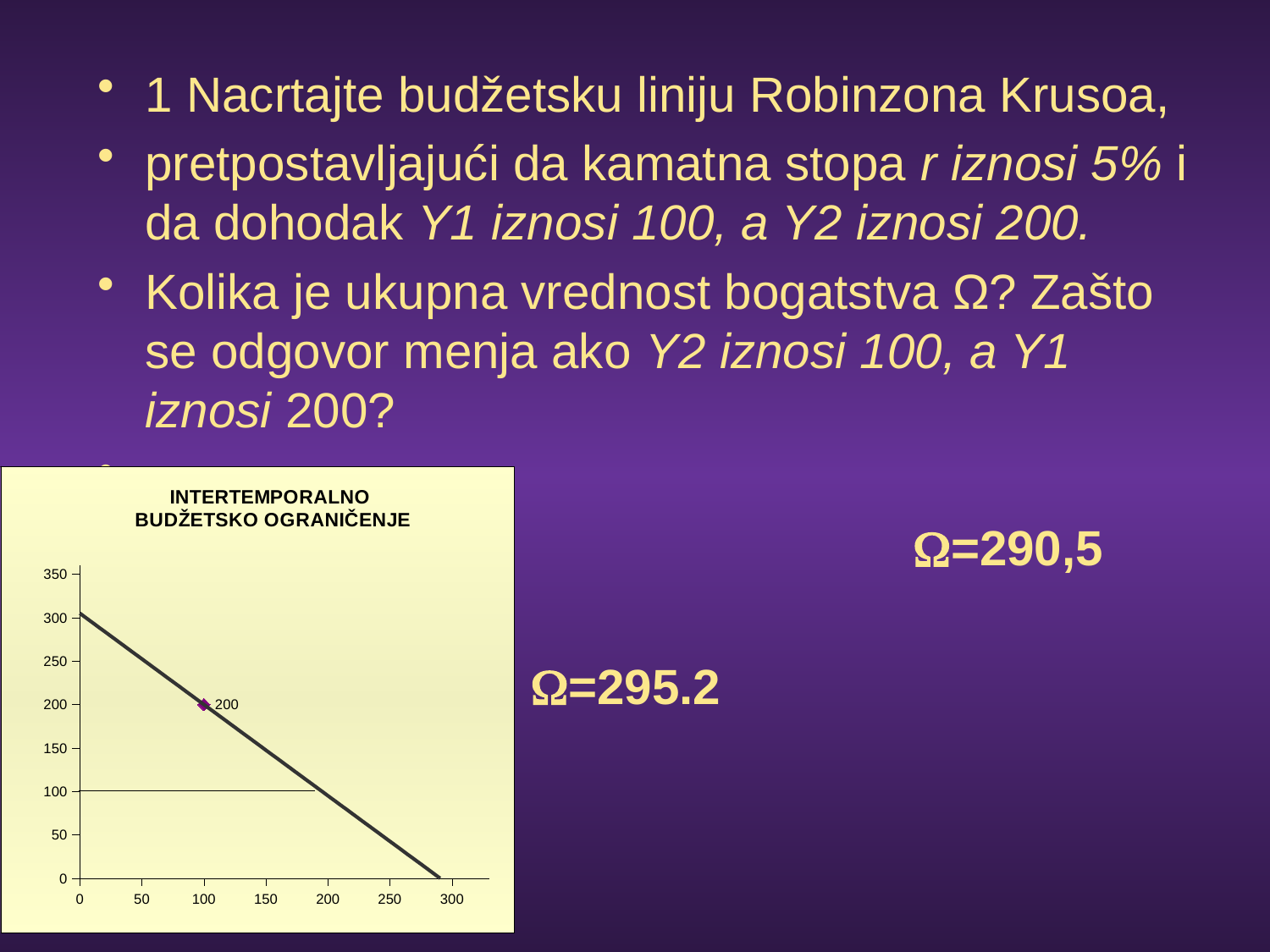
How many tick labels are shown on the horizontal axis? 7 Is the value of the line at x = 150 greater or less than 200? less Is the value of the line at x = 250 greater or less than 100? less Does the line rise or fall as the x-axis value increases? fall What is the title of the chart? INTERTEMPORALNO BUDŽETSKO OGRANIČENJE Is the value of the line at x = 50 greater or less than 200? greater At which x-axis value is the labelled point on the line located? 100 What kind of chart is shown on the slide? line chart What value is printed as the data label on the marked point of the line? 200 What is the highest value shown on the vertical axis? 350